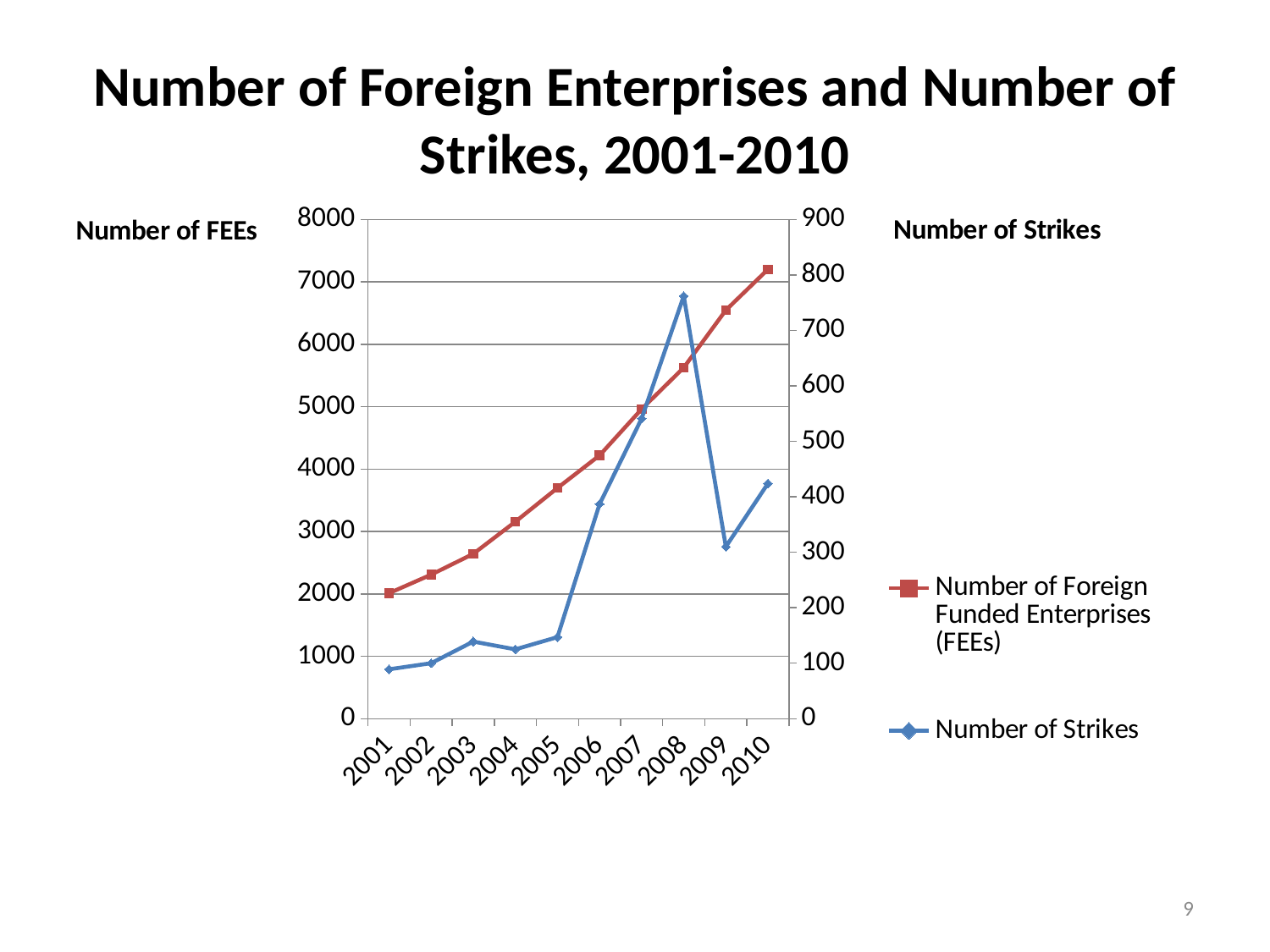
Is the Number of Strikes in 2008 greater or less than 700? greater In which year is the Number of Foreign Funded Enterprises (FEEs) highest? 2010 In which year is the Number of Strikes highest? 2008 Is the Number of Strikes in 2009 greater or less than 400? less Is the Number of Foreign Funded Enterprises (FEEs) in 2010 greater or less than 7000? greater What kind of chart is shown on the slide? line chart Which year has more strikes, 2008 or 2010? 2008 Does the Number of Foreign Funded Enterprises (FEEs) rise or fall from 2001 to 2010? rise What is the label of the right-hand vertical axis? Number of Strikes How many series does the legend list? 2 How many years are plotted along the x axis? 10 In which year is the Number of Strikes lowest? 2001